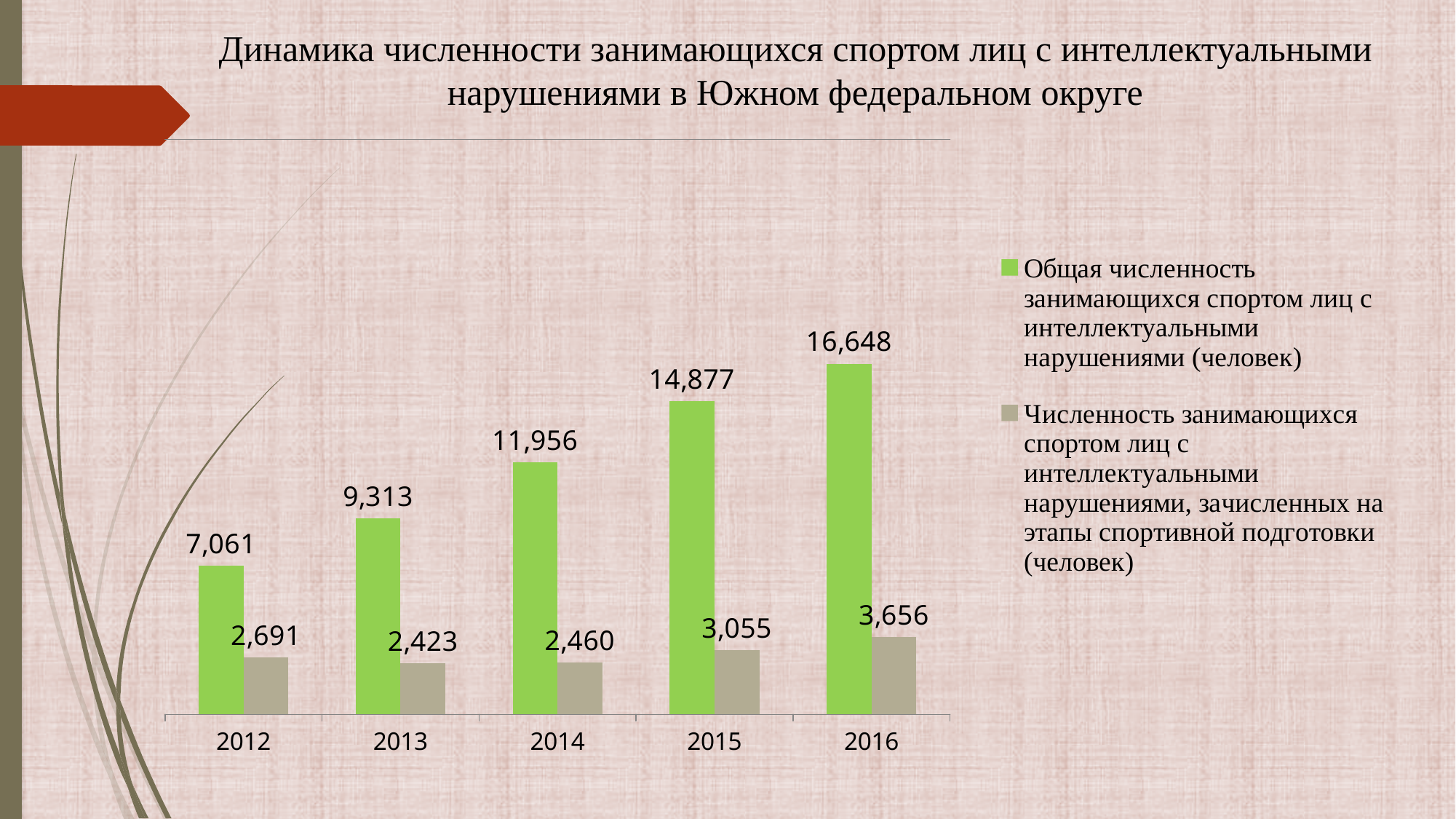
Does the total number of people engaged in sport (green series) rise or fall from 2012 to 2016? Rise What is the value of the green series (total number engaged in sport) in 2012? 7,061 By how much did the total number engaged in sport (green series) increase from 2014 to 2015? 2,921 What kind of chart is shown on the slide? Bar chart In which year is the total number of people engaged in sport (green series) highest? 2016 In which year is the number enrolled in sports training stages (grey series) lowest? 2013 How many years are shown on the x axis? 5 Which is larger: the grey value in 2012 or the grey value in 2013? 2012 What is the total number of people with intellectual disabilities engaged in sport (green series) in 2014? 11,956 What is the difference between the green and grey values in 2016? 12,992 How many series does the legend list? 2 What is the number of people enrolled in sports training stages (grey series) in 2015? 3,055